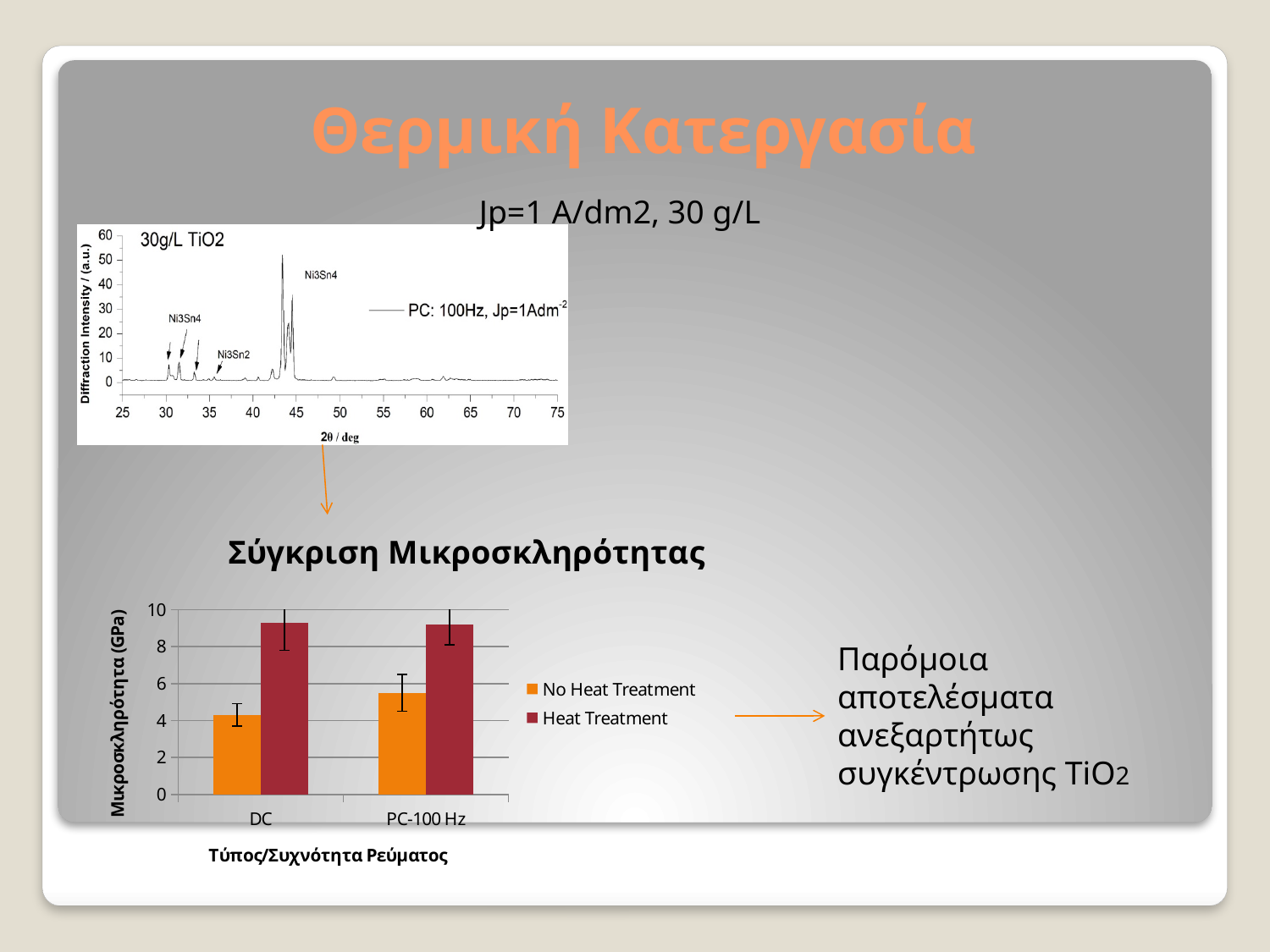
In the 'Σύγκριση Μικροσκληρότητας' chart, is the 'No Heat Treatment' value for DC greater or less than 6? less In the 'Σύγκριση Μικροσκληρότητας' chart, which category has the larger 'No Heat Treatment' value: DC or PC-100 Hz? PC-100 Hz In the 'Σύγκριση Μικροσκληρότητας' chart, is the 'Heat Treatment' value for PC-100 Hz greater or less than 8? greater How many categories are shown on the x axis of the 'Σύγκριση Μικροσκληρότητας' chart? 2 What kind of chart is the 'Σύγκριση Μικροσκληρότητας' chart at the bottom of the slide? bar chart In the 'Σύγκριση Μικροσκληρότητας' chart, is the 'Heat Treatment' value for DC greater or less than 8? greater What is the y-axis title of the 'Σύγκριση Μικροσκληρότητας' chart? Μικροσκληρότητα (GPa) In the 'Σύγκριση Μικροσκληρότητας' chart, which is larger for DC: 'No Heat Treatment' or 'Heat Treatment'? Heat Treatment In the 'Σύγκριση Μικροσκληρότητας' chart, which bar is the lowest overall? No Heat Treatment for DC How many series does the legend of the 'Σύγκριση Μικροσκληρότητας' chart list? 2